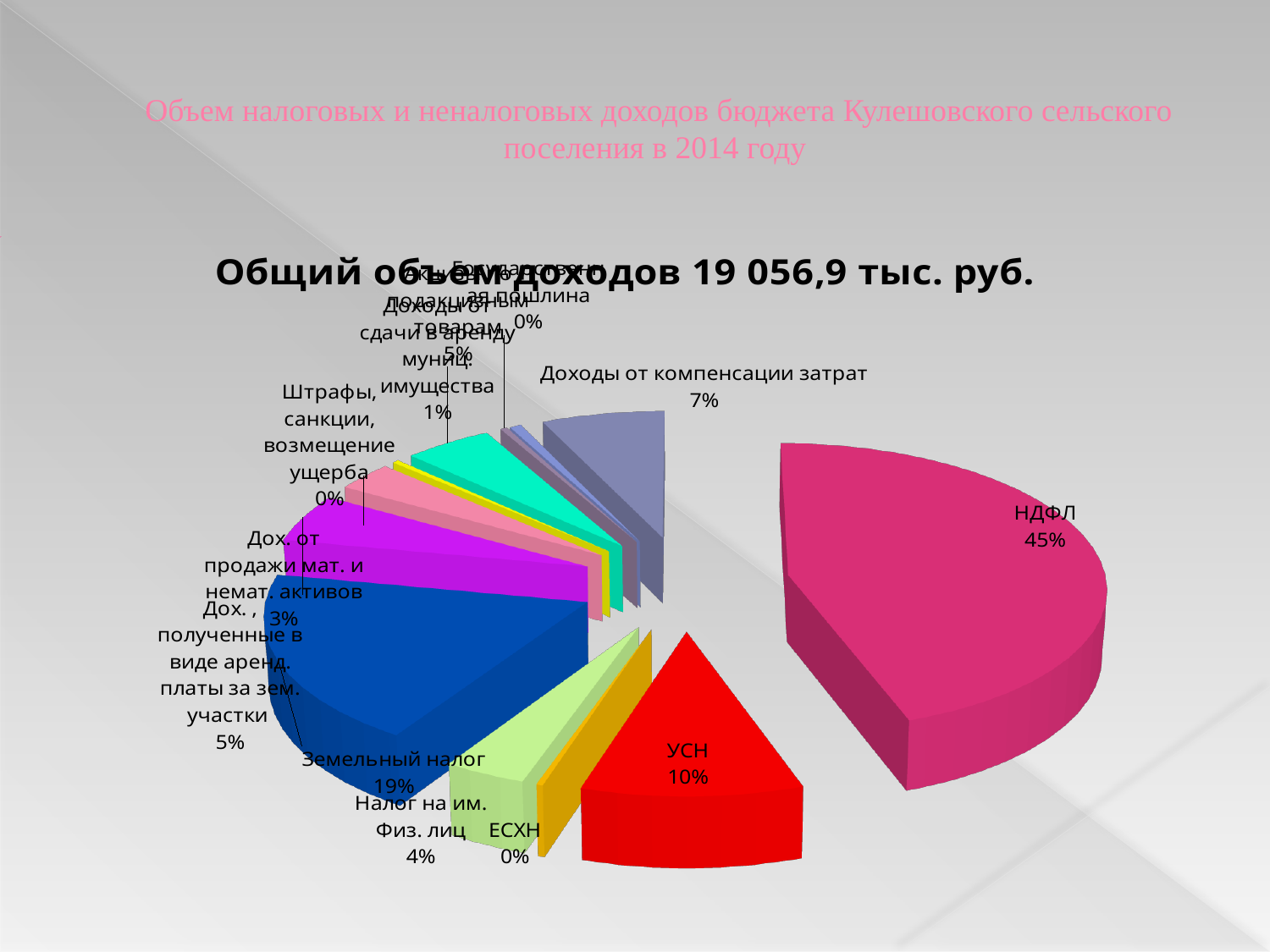
What is the value shown for УСН? 10% What share of the pie does НДФЛ account for? 45% Which is larger, the share for Земельный налог or the share for УСН? Земельный налог What is the value shown for ЕСХН? 0% What kind of chart is shown on the slide? Pie chart What is the value shown for Земельный налог? 19% Which category has the largest share of the pie? НДФЛ What total revenue amount is stated in the chart title? 19 056,9 тыс. руб. What is the difference in percentage points between НДФЛ and Земельный налог? 26 What is the value shown for Налог на им. Физ. лиц? 4% What is the value shown for Дох. от продажи мат. и немат. активов? 3% What is the value shown for Доходы от компенсации затрат? 7%